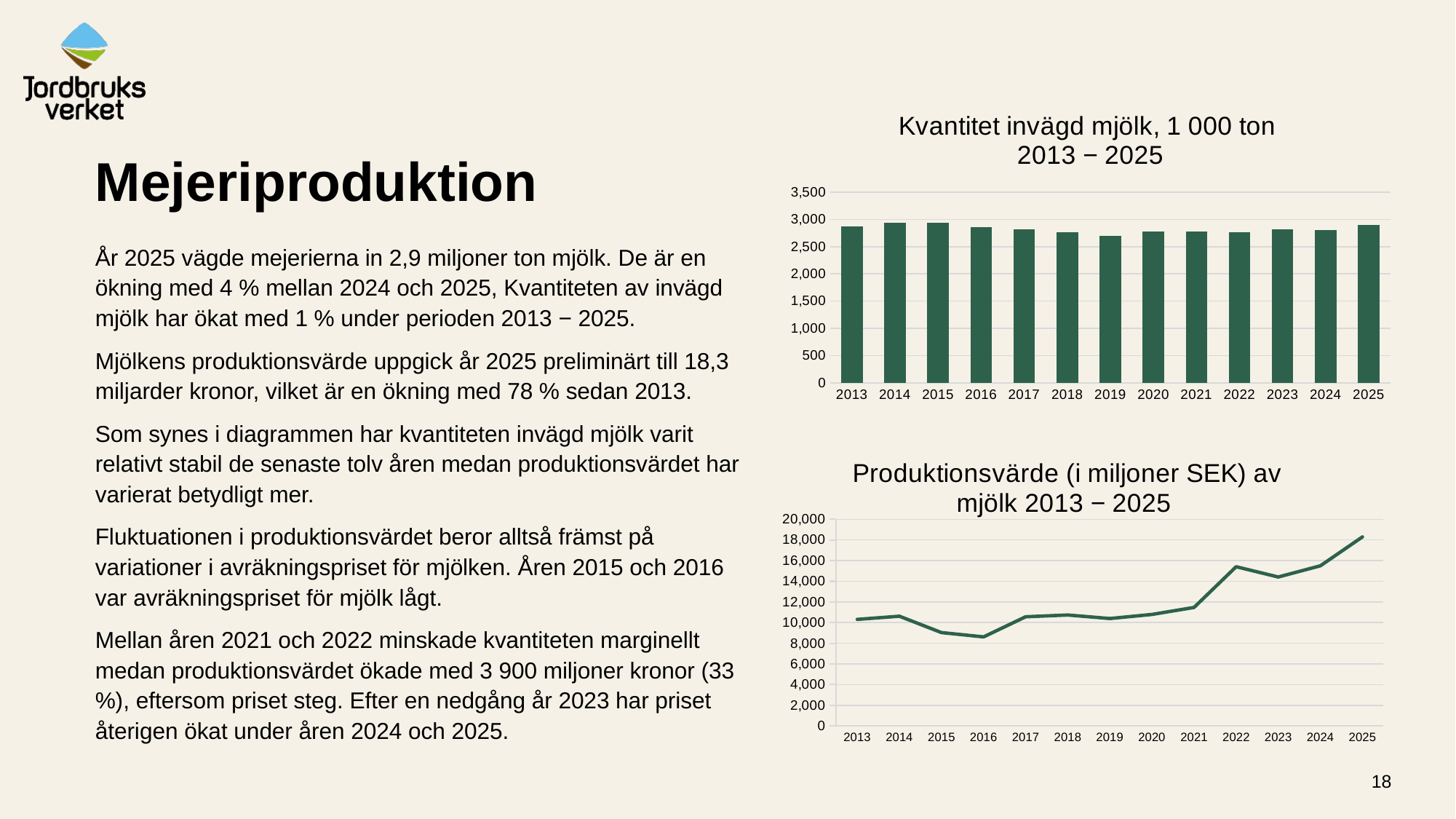
In the top chart (Kvantitet invägd mjölk), is the value for 2019 greater or less than 3,000? less In the bottom chart (Produktionsvärde), which is larger, the value for 2022 or the value for 2023? 2022 What type of chart is the bottom chart titled "Produktionsvärde (i miljoner SEK) av mjölk 2013 − 2025"? line chart In the bottom chart (Produktionsvärde), is the value for 2025 greater or less than 16,000? greater In the top chart (Kvantitet invägd mjölk), how many years are shown on the x axis? 13 In the bottom chart (Produktionsvärde), is the value for 2016 greater or less than 10,000? less In the bottom chart (Produktionsvärde), do the values overall rise or fall from 2013 to 2025? rise In the bottom chart (Produktionsvärde), how many years are shown on the x axis? 13 In the bottom chart (Produktionsvärde), which year has the highest value? 2025 What type of chart is the top chart titled "Kvantitet invägd mjölk, 1 000 ton 2013 − 2025"? bar chart In the top chart (Kvantitet invägd mjölk), which year has the lowest bar? 2019